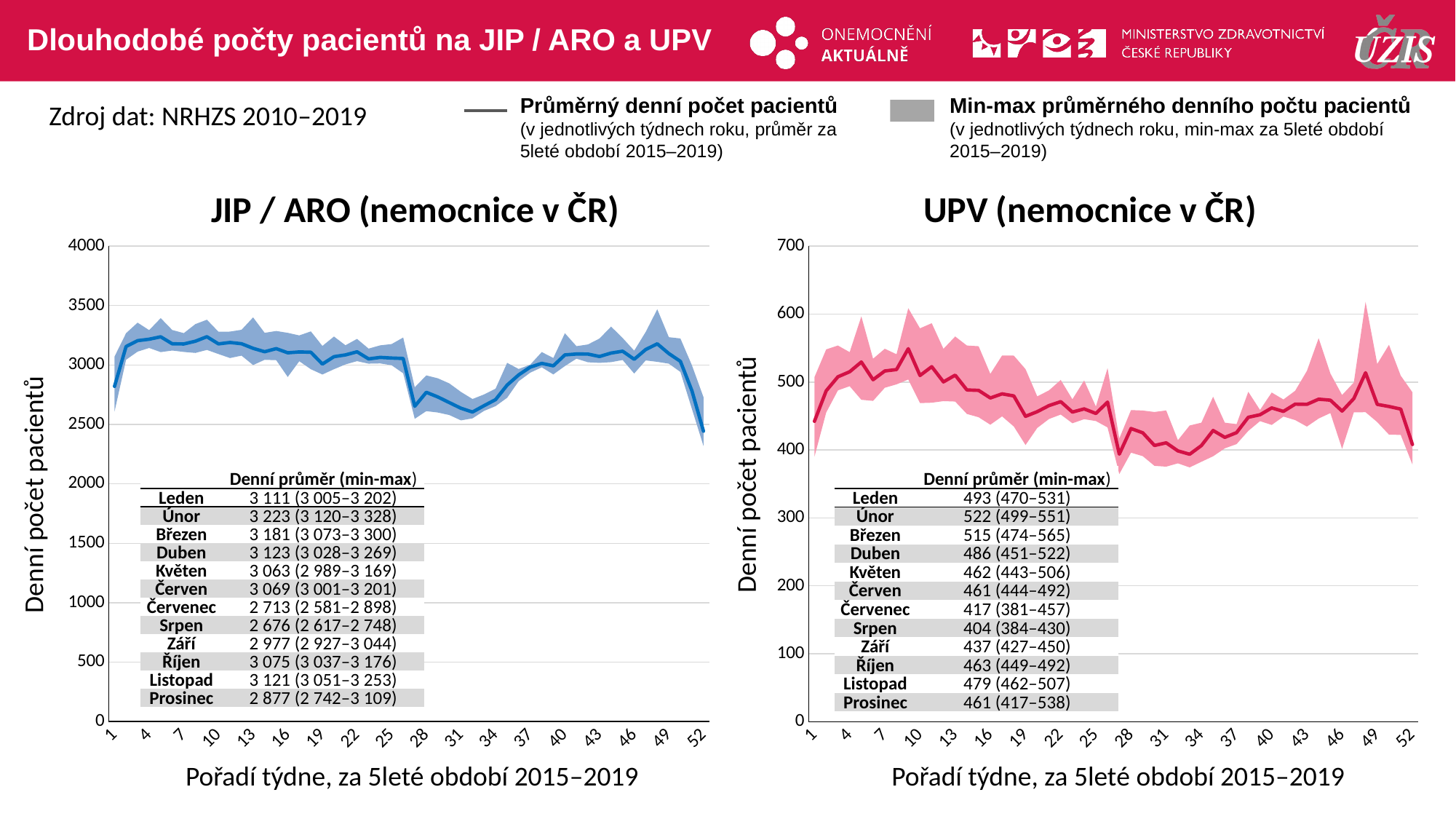
In the UPV (nemocnice v ČR) chart's table, which month has the larger daily average, Leden or Listopad? Leden What kind of chart is the JIP / ARO (nemocnice v ČR) chart? line chart In the JIP / ARO (nemocnice v ČR) chart's table, which month has the highest daily average? Únor In the UPV (nemocnice v ČR) chart's table, what is the daily average (Denní průměr) for Srpen? 404 In the JIP / ARO (nemocnice v ČR) chart's table, what is the difference between the daily averages for Únor and Srpen? 547 In the UPV (nemocnice v ČR) chart's table, what is the min-max range shown for Prosinec? 417–538 In the JIP / ARO (nemocnice v ČR) chart, is the average line value at week 28 greater or less than 3000? less In the UPV (nemocnice v ČR) chart's table, what is the difference between the daily averages for Únor and Srpen? 118 In the JIP / ARO (nemocnice v ČR) chart's table, what is the daily average (Denní průměr) for Únor? 3 223 In the UPV (nemocnice v ČR) chart's table, which month has the lowest daily average? Srpen What is the y-axis label of the UPV (nemocnice v ČR) chart? Denní počet pacientů